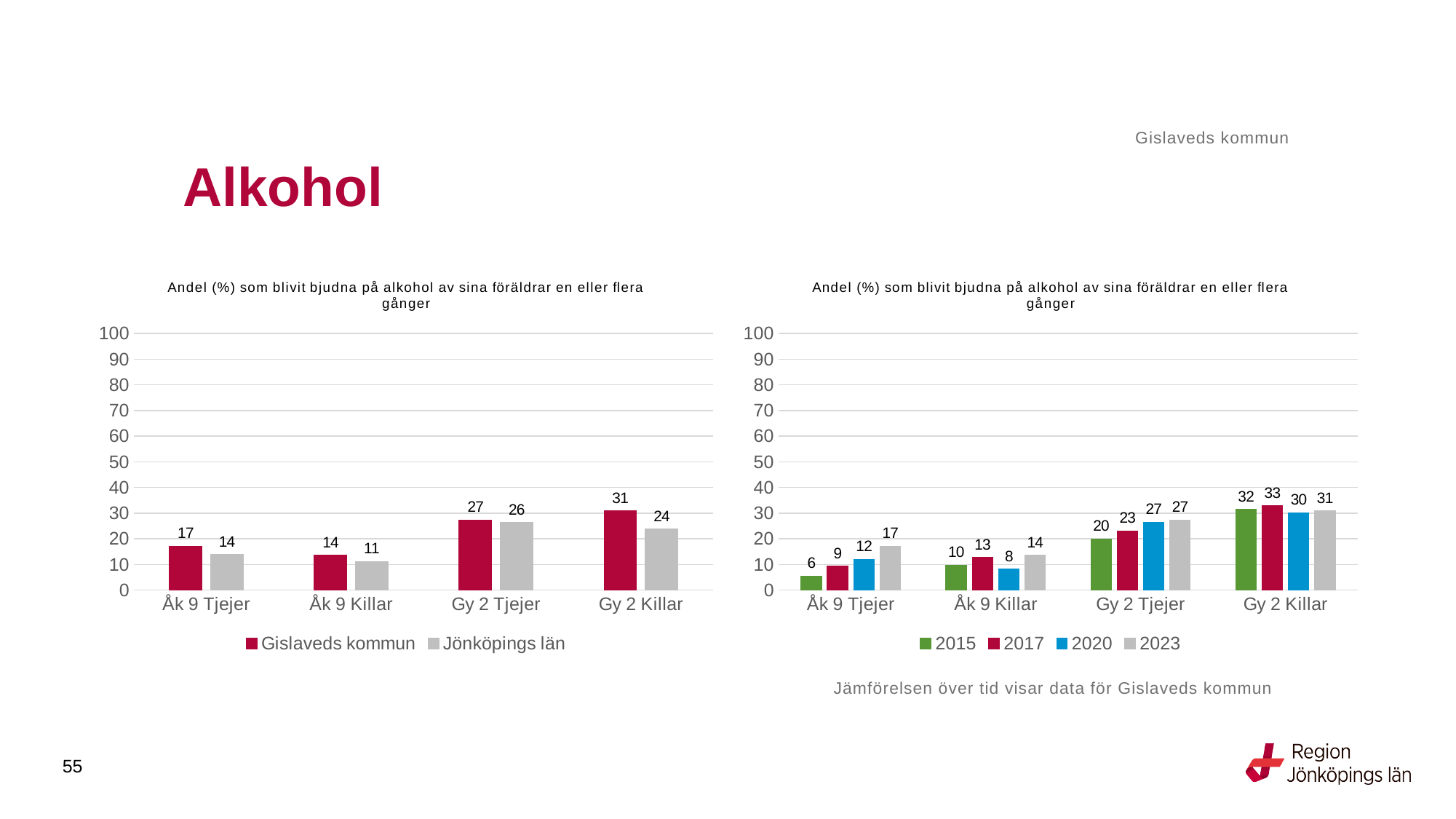
What kind of chart is the left chart? bar chart In the right chart, what is the value for 2023 for Gy 2 Tjejer? 27 In the left chart, what is the value for Jönköpings län for Åk 9 Killar? 11 In the right chart, how many series does the legend list? 4 In the left chart, which category has the highest value for Gislaveds kommun? Gy 2 Killar In the right chart, do the values for Åk 9 Tjejer rise or fall from 2015 to 2023? rise In the left chart, what is the difference between Gislaveds kommun and Jönköpings län for Gy 2 Killar? 7 In the right chart, is the value for 2017 for Gy 2 Killar larger or smaller than the value for 2020 for Gy 2 Killar? larger In the right chart, which category has the lowest value for 2015? Åk 9 Tjejer In the left chart, how many series does the legend list? 2 In the left chart, what is the value for Gislaveds kommun for Gy 2 Killar? 31 In the right chart, what is the value for 2020 for Åk 9 Killar? 8